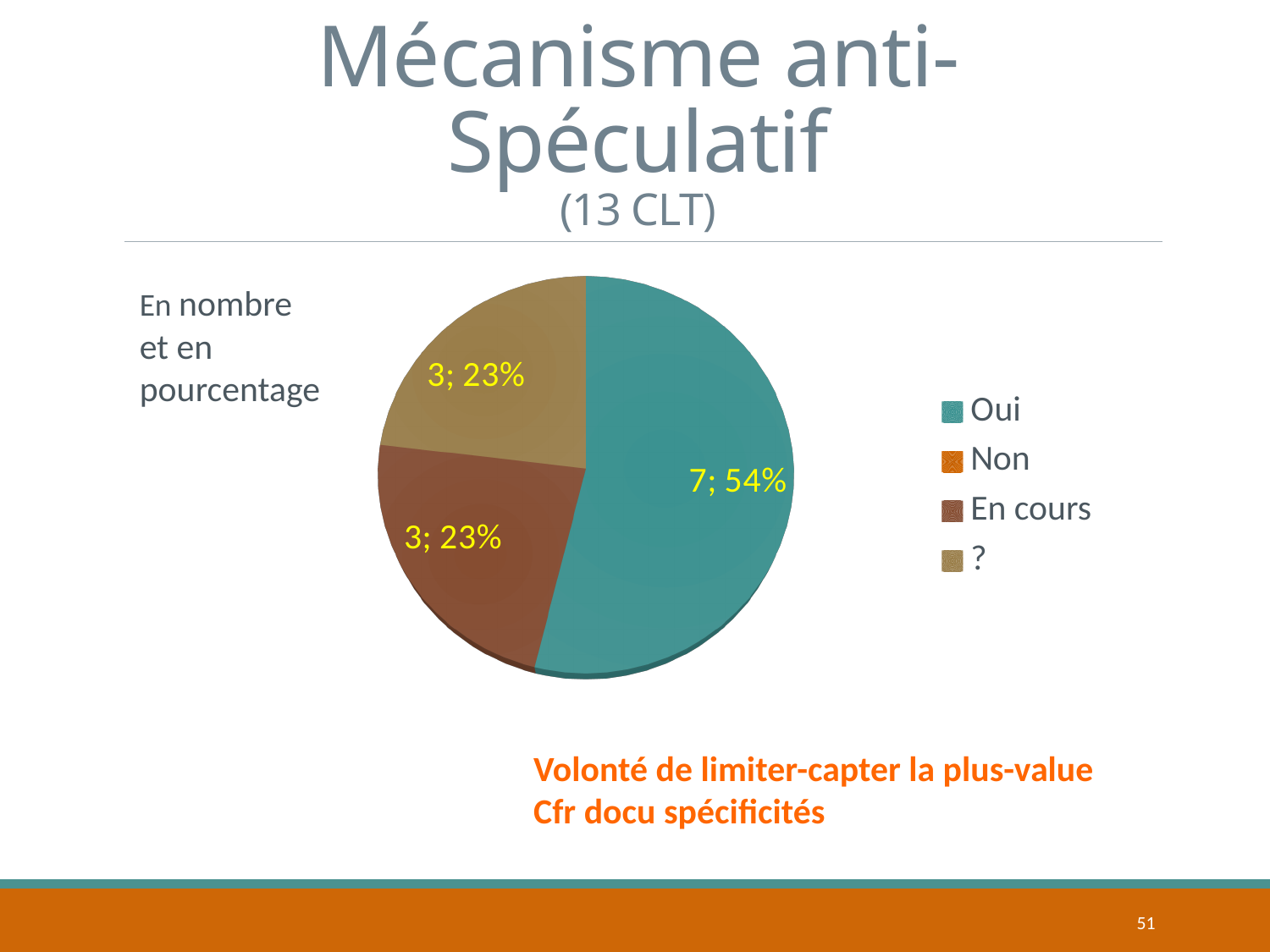
What percentage share does the 'Oui' slice represent? 54% What kind of chart is shown on the slide? pie chart How many entries does the legend of the pie chart list? 4 What is the total number of CLT represented in the pie chart? 13 What is the difference between the number for 'Oui' and the number for 'En cours'? 4 What is the number shown for the 'Oui' slice of the pie chart? 7 How many slices are visible in the pie chart? 3 What is the number shown for the 'En cours' slice? 3 Which is larger, the 'Oui' slice or the '?' slice? Oui Which category has the largest slice in the pie chart? Oui What percentage share does the '?' slice represent? 23% What is the title of the slide containing the pie chart? Mécanisme anti-Spéculatif (13 CLT)